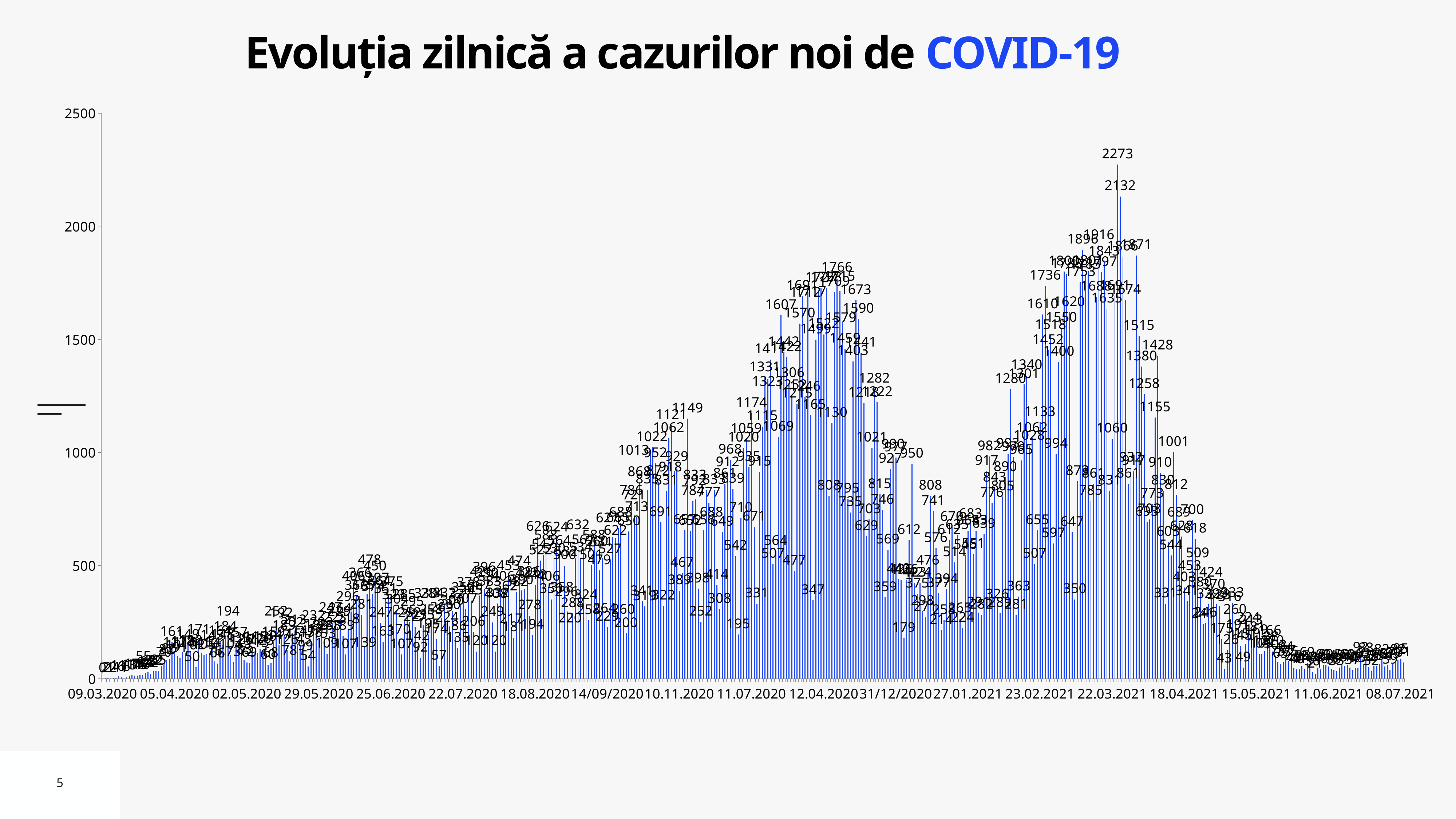
What is the difference between the peak value 2273 and the peak value 1766? 507 Which is larger: the peak of 2273 near 22.03.2021 or the peak of 1766 near 12.04.2020? 2273 Is the highest bar on the chart greater or less than 2000? greater What is the title of the chart? Evoluția zilnică a cazurilor noi de COVID-19 What is the maximum value shown on the y axis? 2500 What is the highest labelled value in the wave around the 12.04.2020 x-axis label? 1766 What kind of chart is shown on the slide? bar chart What is the difference between the two highest labelled values, 2273 and 2132? 141 What is the second-highest value labelled on the chart? 2132 Do the values rise or fall between the 15.05.2021 and 08.07.2021 x-axis labels? fall Near which x-axis date label does the highest bar (2273) occur? 22.03.2021 What is the highest value labelled on the chart? 2273